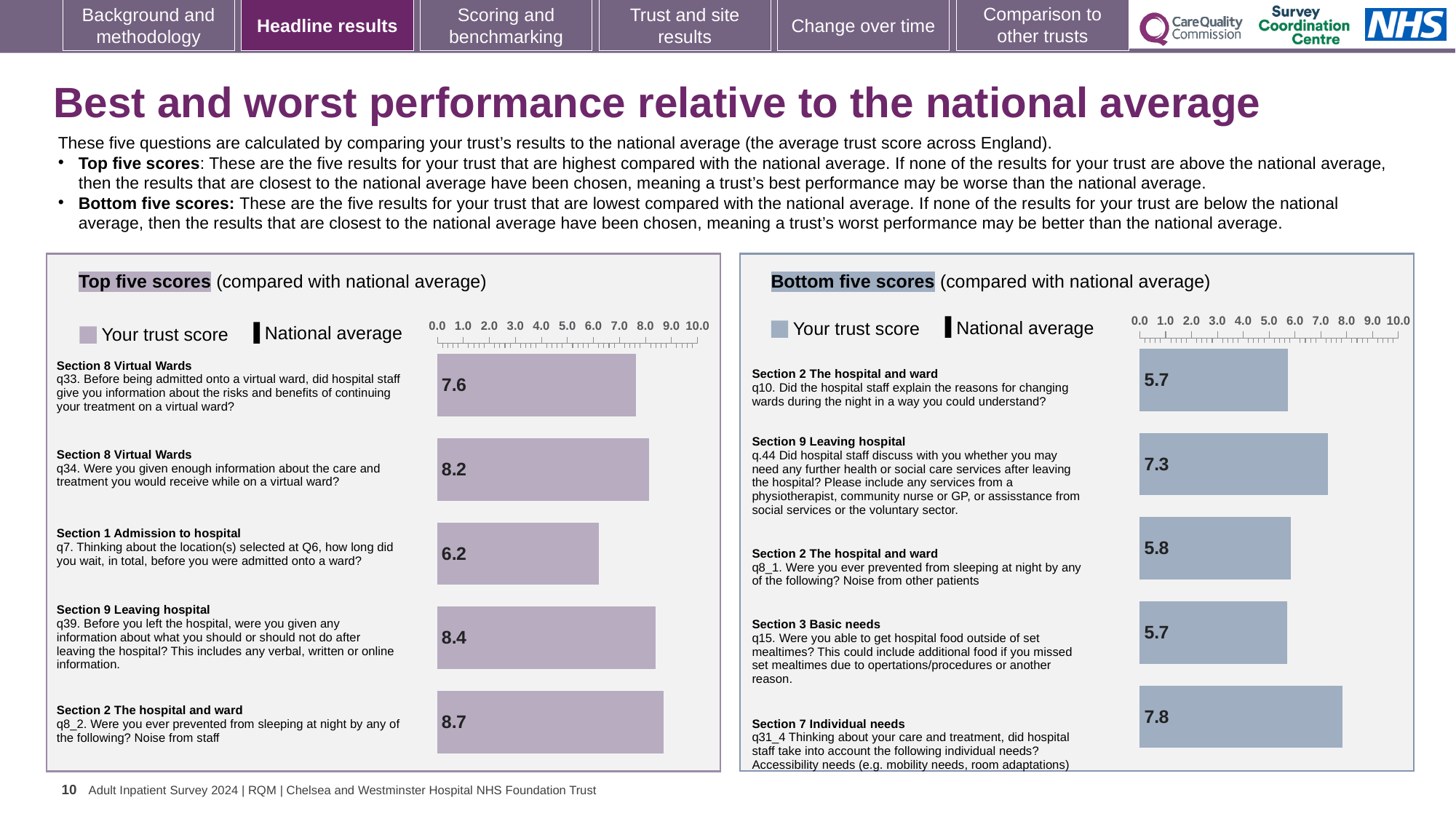
In the Bottom five scores chart, which has the larger trust score: q.44 (further health or social care services after leaving) or q8_1 (Noise from other patients)? q.44 (further health or social care services after leaving) In the Bottom five scores chart, what is the trust score for q31_4 (Accessibility needs)? 7.8 How many entries does the legend of the Top five scores chart list? 2 In the Top five scores chart, which question has the lowest trust score? q7. Thinking about the location(s) selected at Q6, how long did you wait, in total, before you were admitted onto a ward? In the Bottom five scores chart, what is the trust score for q.44 (Did hospital staff discuss with you whether you may need any further health or social care services after leaving the hospital)? 7.3 In the Top five scores chart, what is the trust score for q7 (how long did you wait before being admitted onto a ward)? 6.2 In the Top five scores chart, what is the trust score for q34 (Were you given enough information about the care and treatment you would receive while on a virtual ward?)? 8.2 What type of chart is used in the Top five scores panel? Bar chart In the Top five scores chart, which question has the highest trust score? q8_2. Were you ever prevented from sleeping at night by any of the following? Noise from staff How many questions are shown in the Bottom five scores chart? 5 In the Bottom five scores chart, which question has the highest trust score? q31_4 Thinking about your care and treatment, did hospital staff take into account the following individual needs? Accessibility needs In the Top five scores chart, what is the difference between the trust scores for q8_2 (Noise from staff) and q7 (wait before admission to a ward)? 2.5